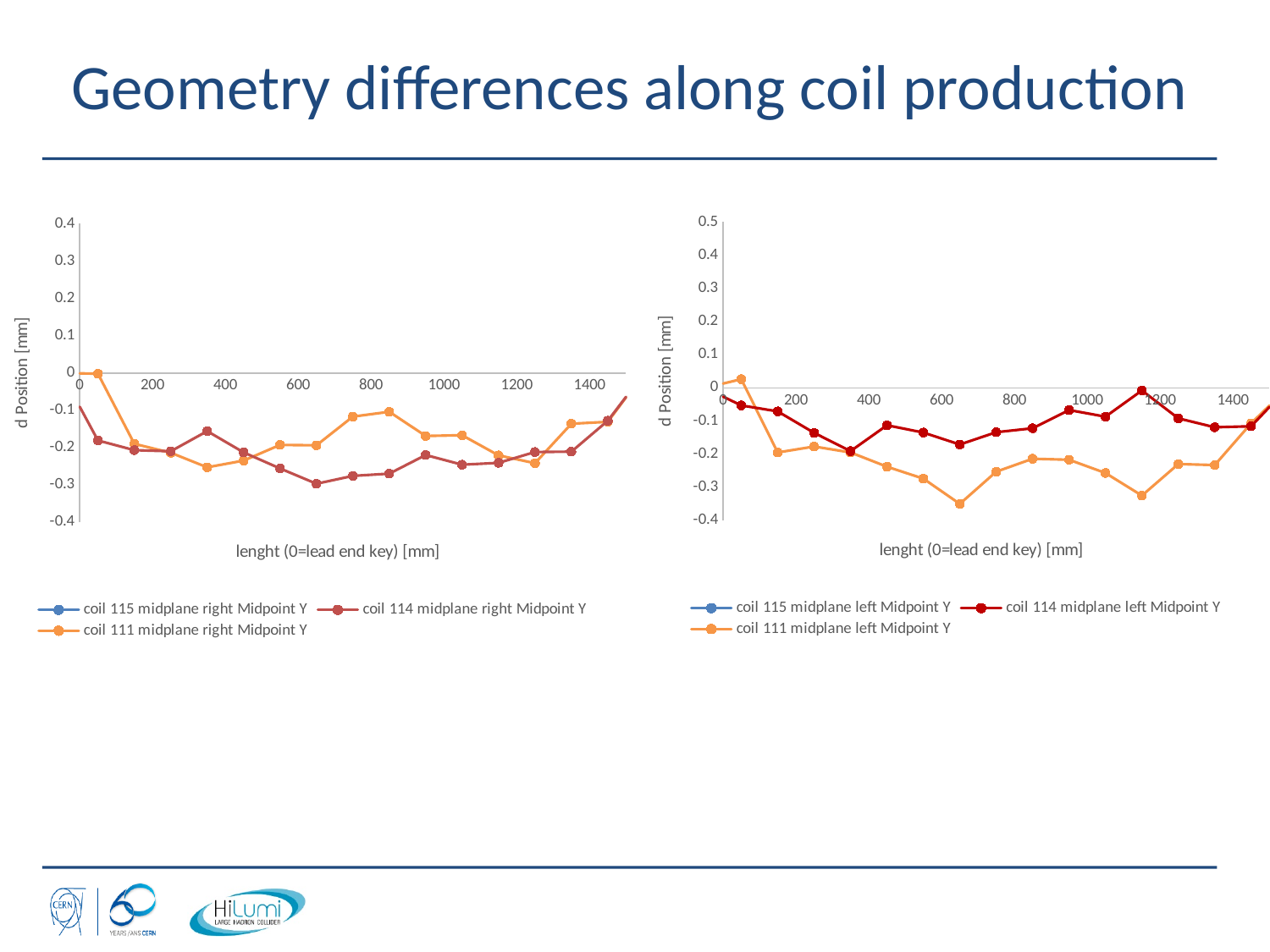
In the right chart (midplane left), does coil 111 midplane left Midpoint Y rise or fall between length 0 and length 650? fall What is the y-axis title of the right chart (midplane left)? d Position [mm] In the right chart (midplane left), at which length does coil 111 midplane left Midpoint Y reach its lowest value? 650 How many series does the legend of the right chart (midplane left) list? 3 What kind of chart is the left chart (midplane right)? line chart In the left chart (midplane right), is the value of coil 114 midplane right Midpoint Y at length 650 greater or less than -0.2? less In the right chart (midplane left), at length 650, which series has the larger value: coil 114 midplane left Midpoint Y or coil 111 midplane left Midpoint Y? coil 114 midplane left Midpoint Y In the right chart (midplane left), is the value of coil 111 midplane left Midpoint Y at length 650 greater or less than -0.3? less In the left chart (midplane right), at length 750, which series has the larger value: coil 111 midplane right Midpoint Y or coil 114 midplane right Midpoint Y? coil 111 midplane right Midpoint Y In the left chart (midplane right), is the value of coil 111 midplane right Midpoint Y at length 350 greater or less than -0.2? less What is the x-axis title of the left chart (midplane right)? lenght (0=lead end key) [mm]